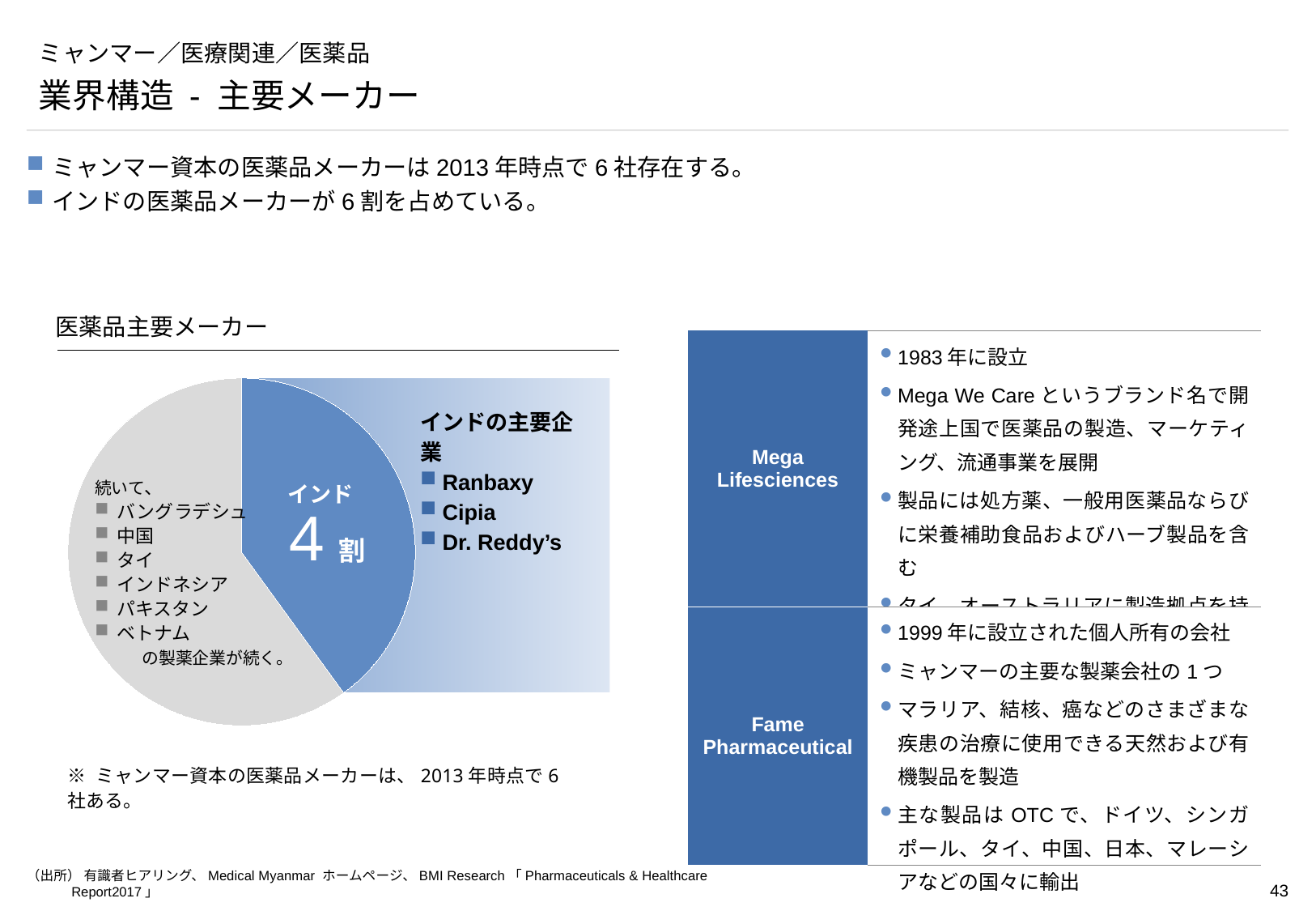
What share of the pie chart is labelled for インド? 4割 Which slice of the pie chart is larger, the インド slice or the grey slice for the other countries? the grey slice for the other countries How many slices does the pie chart have? 2 How many Indian companies are listed next to the pie chart under インドの主要企業? 3 What kind of chart is shown under the title 医薬品主要メーカー? pie chart What colour is the インド slice in the pie chart? blue How many countries are listed in the grey slice of the pie chart after 続いて、? 6 What is the title of the pie chart? 医薬品主要メーカー